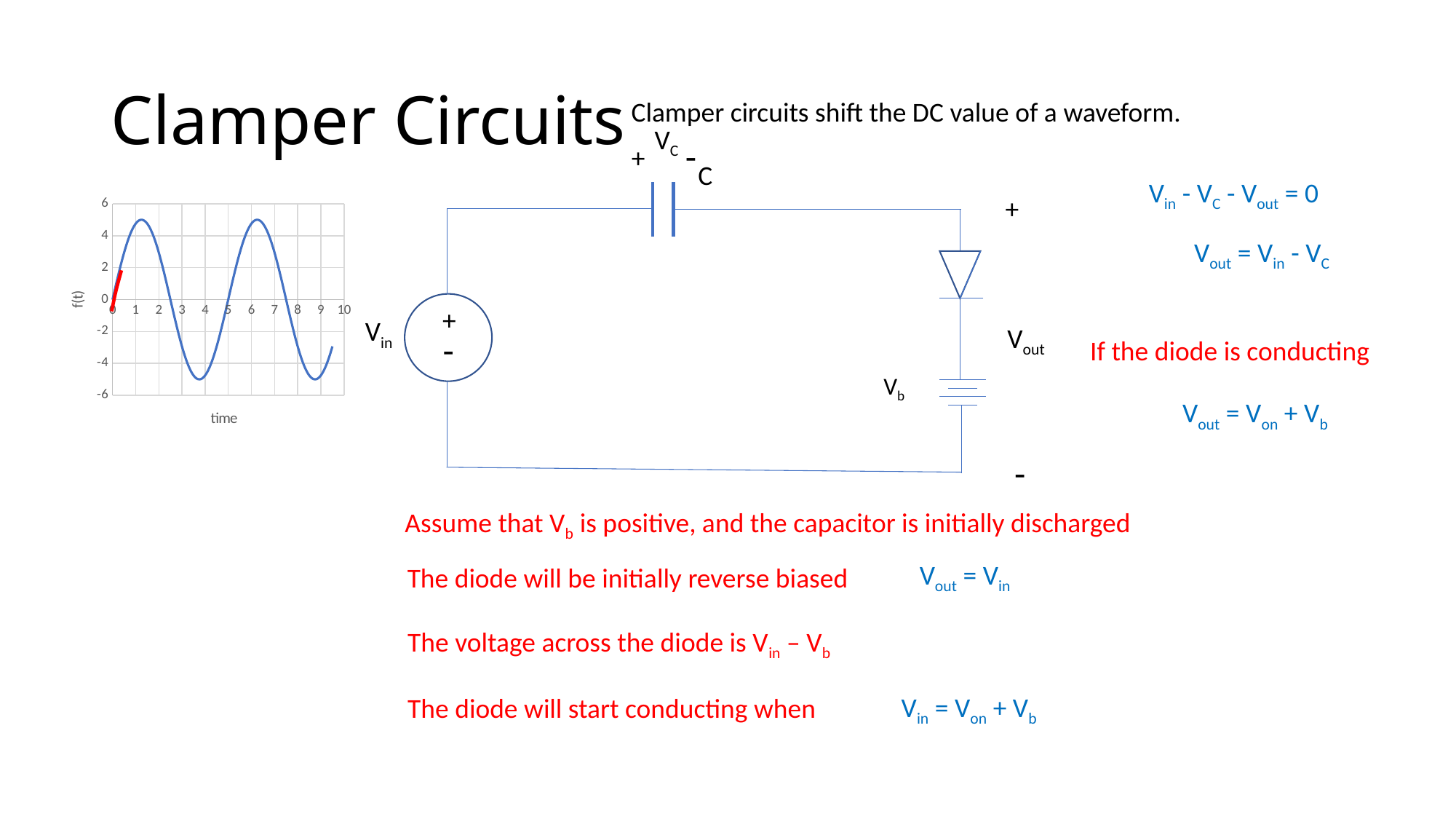
What is the lowest value labeled on the vertical axis of the chart? -6 Is the value of f(t) at time 4 greater or less than -2? less How many tick labels are shown on the horizontal axis of the chart? 11 Does the curve rise or fall between time 0 and time 1? rise Is the value of f(t) at time 1 greater or less than 2? greater What is the largest value labeled on the horizontal axis of the chart? 10 Does the curve rise or fall between time 2 and time 4? fall What is the highest value labeled on the vertical axis of the chart? 6 What is the label of the vertical axis of the chart? f(t) What is the label of the horizontal axis of the chart? time What kind of chart is shown on the left of the slide? line chart Is the value of f(t) at time 6 greater or less than 2? greater